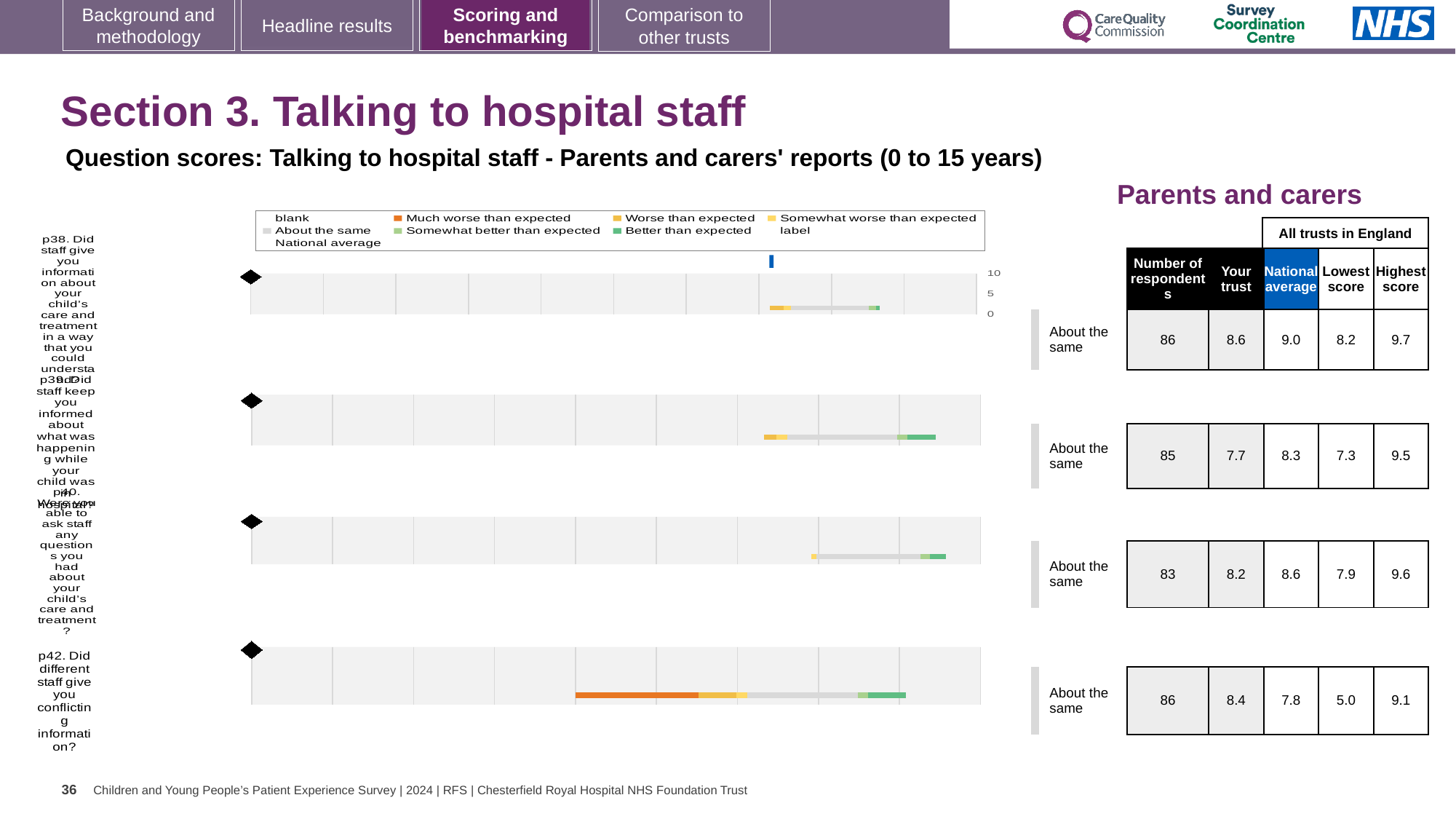
What benchmark category is shown next to the p40 chart? About the same In the p38 chart, what is the difference between the National average score and the 'Your trust' score? 0.4 Across the four question charts on the slide, which question has the highest 'Your trust' score? p38 How many question charts are shown on the slide? 4 In the p38 chart (staff giving information about your child's care in a way you could understand), what is the 'Your trust' score shown in the table? 8.6 In the p40 chart (being able to ask staff any questions about your child's care and treatment), how many respondents are listed? 83 Across the four question charts on the slide, which question has the lowest 'Your trust' score? p39 In the p42 chart (different staff giving conflicting information), what is the Lowest score among all trusts in England? 5.0 In the p39 chart (staff keeping you informed about what was happening while your child was in hospital), what is the National average score? 8.3 In the p42 chart, which is larger: the 'Your trust' score or the National average score? Your trust In the p42 chart, what is the difference between the Highest score and the Lowest score among all trusts in England? 4.1 In the legend above the charts, what colour represents 'Much worse than expected'? Orange